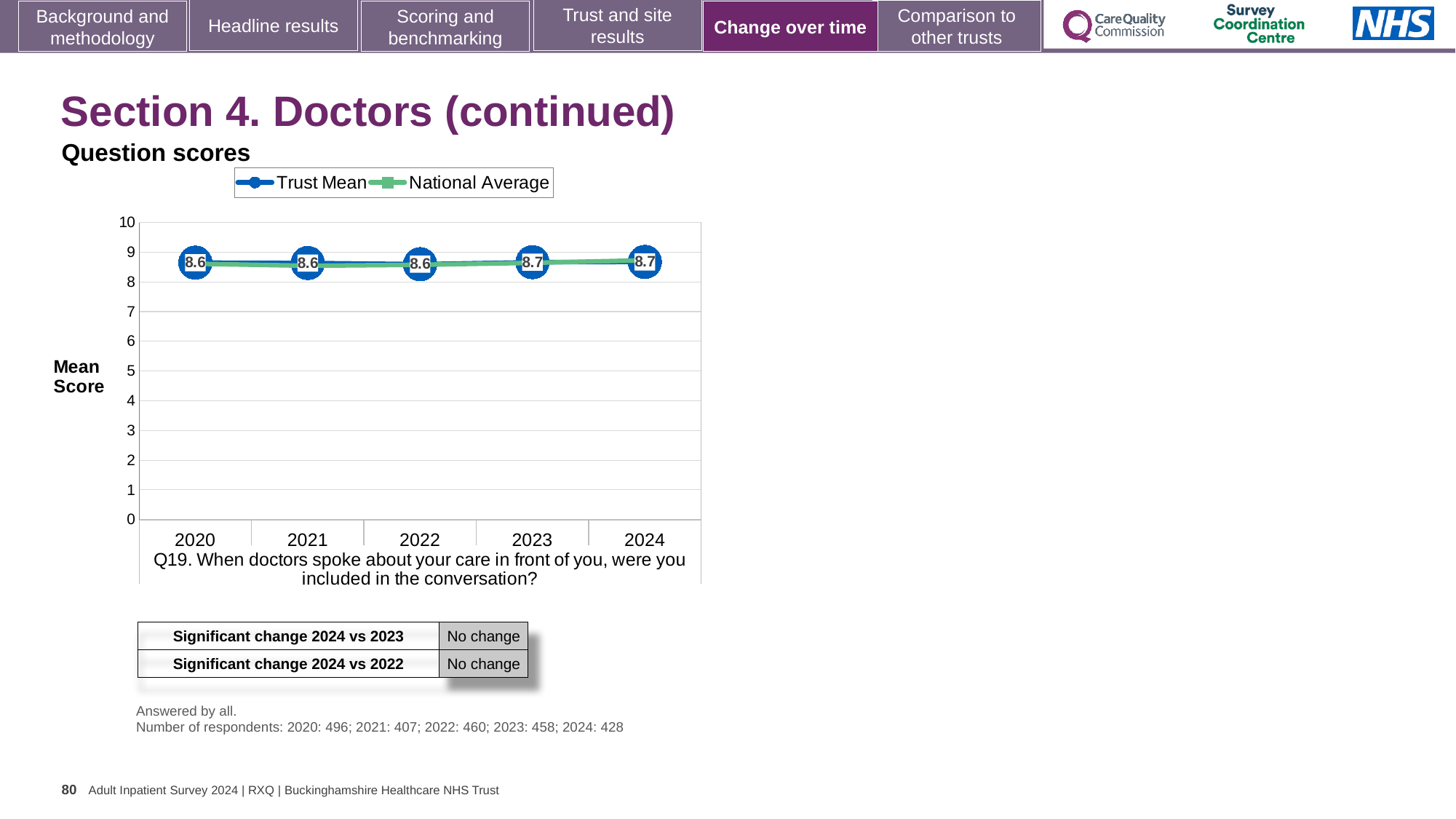
What kind of chart is shown? Line chart Which is larger, the Trust Mean in 2020 or in 2024? 2024 What is the Trust Mean for 2023? 8.7 What are the two series named in the legend? Trust Mean and National Average What is the Trust Mean for 2020? 8.6 How many years are plotted on the x axis? 5 What is the Trust Mean for 2024? 8.7 What is the Trust Mean for 2022? 8.6 What is the difference between the Trust Mean in 2024 and in 2020? 0.1 Is the National Average for 2021 greater or less than 8? greater Does the Trust Mean rise or fall from 2020 to 2024? Rise How many series does the legend list? 2